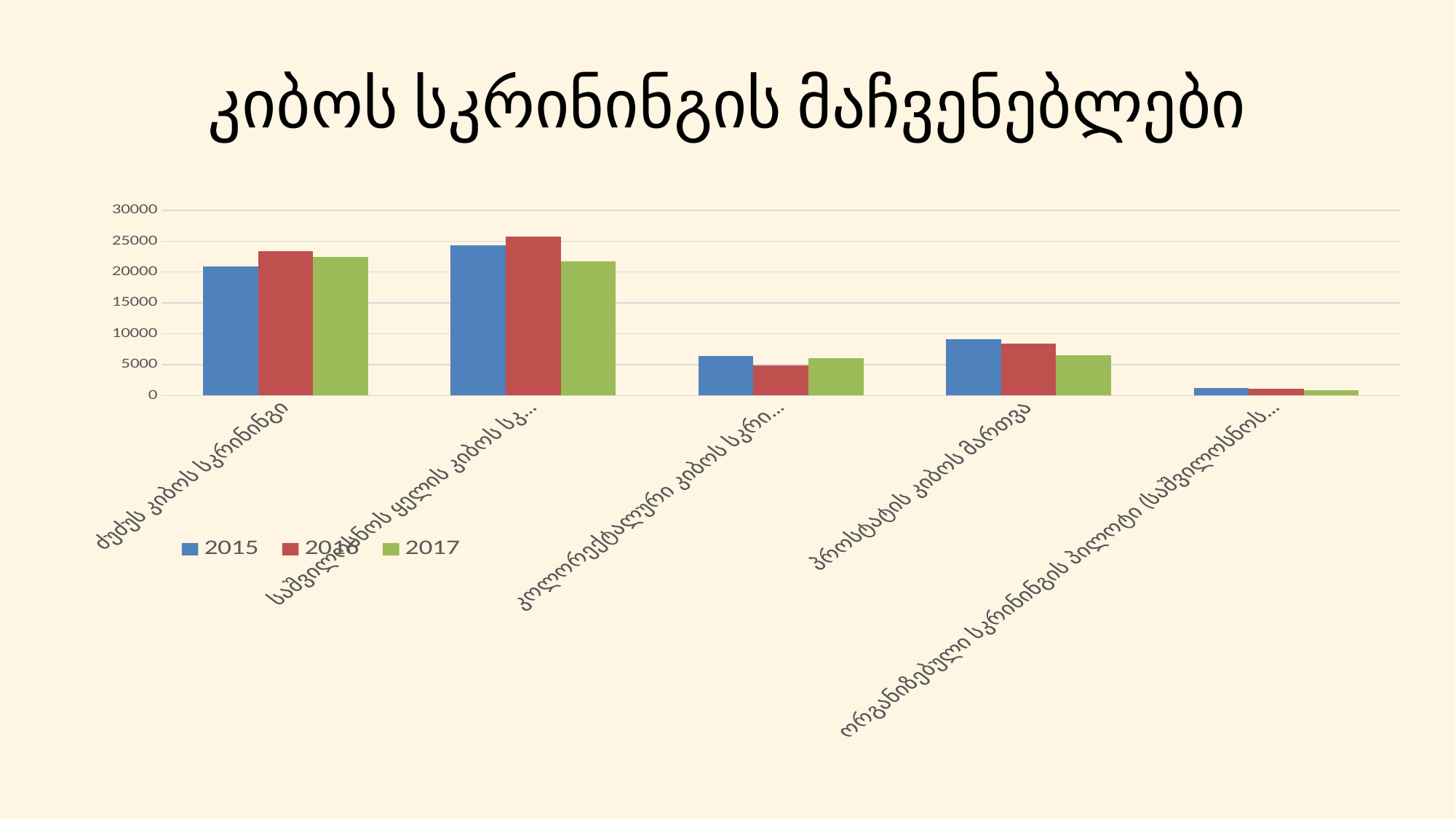
Which category has the highest value for the 2016 series? საშვილოსნოს ყელის კიბოს სკ... What is the title of the chart slide? კიბოს სკრინინგის მაჩვენებლები Which category has the lowest value for the 2015 series? ორგანიზებული სკრინინგის პილოტი (საშვილოსნოს... For პროსტატის კიბოს მართვა, which is larger: the 2015 value or the 2017 value? 2015 For ძუძუს კიბოს სკრინინგი, which is larger: the 2015 value or the 2016 value? 2016 Is the 2015 value for პროსტატის კიბოს მართვა greater or less than 10000? less How many series does the legend list? 3 For პროსტატის კიბოს მართვა, do the values rise or fall from 2015 to 2017? fall How many categories are shown on the x axis? 5 What kind of chart is shown on the slide? bar chart Is the 2016 value for ძუძუს კიბოს სკრინინგი greater or less than 25000? less Is the 2015 value for კოლორექტალური კიბოს სკრი... greater or less than 5000? greater